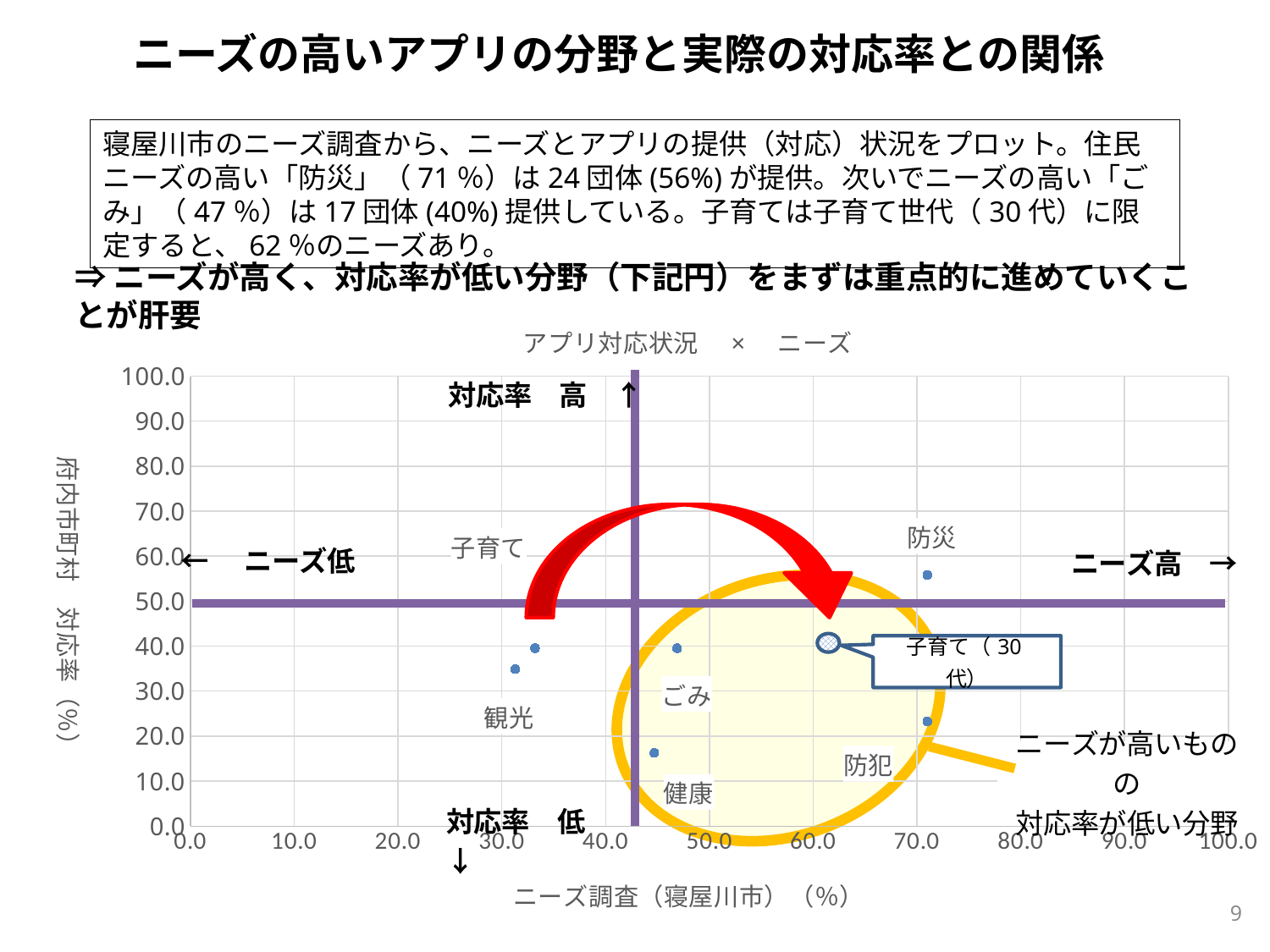
Which labelled point has the highest 対応率 (y value) on the chart? 防災 Is the 対応率 (y value) for 防犯 greater or less than 30.0? less Is the 対応率 (y value) for 健康 greater or less than 20.0? less Which has the higher 対応率 (y value), 防災 or 防犯? 防災 Which labelled point has the lowest 対応率 (y value) on the chart? 健康 What is the label of the x axis of the chart? ニーズ調査（寝屋川市）（%） What is the title of the chart? アプリ対応状況 × ニーズ What kind of chart is shown on the slide? scatter chart Which has the higher 対応率 (y value), ごみ or 健康? ごみ Is the 対応率 (y value) for 防災 greater or less than 50.0? greater